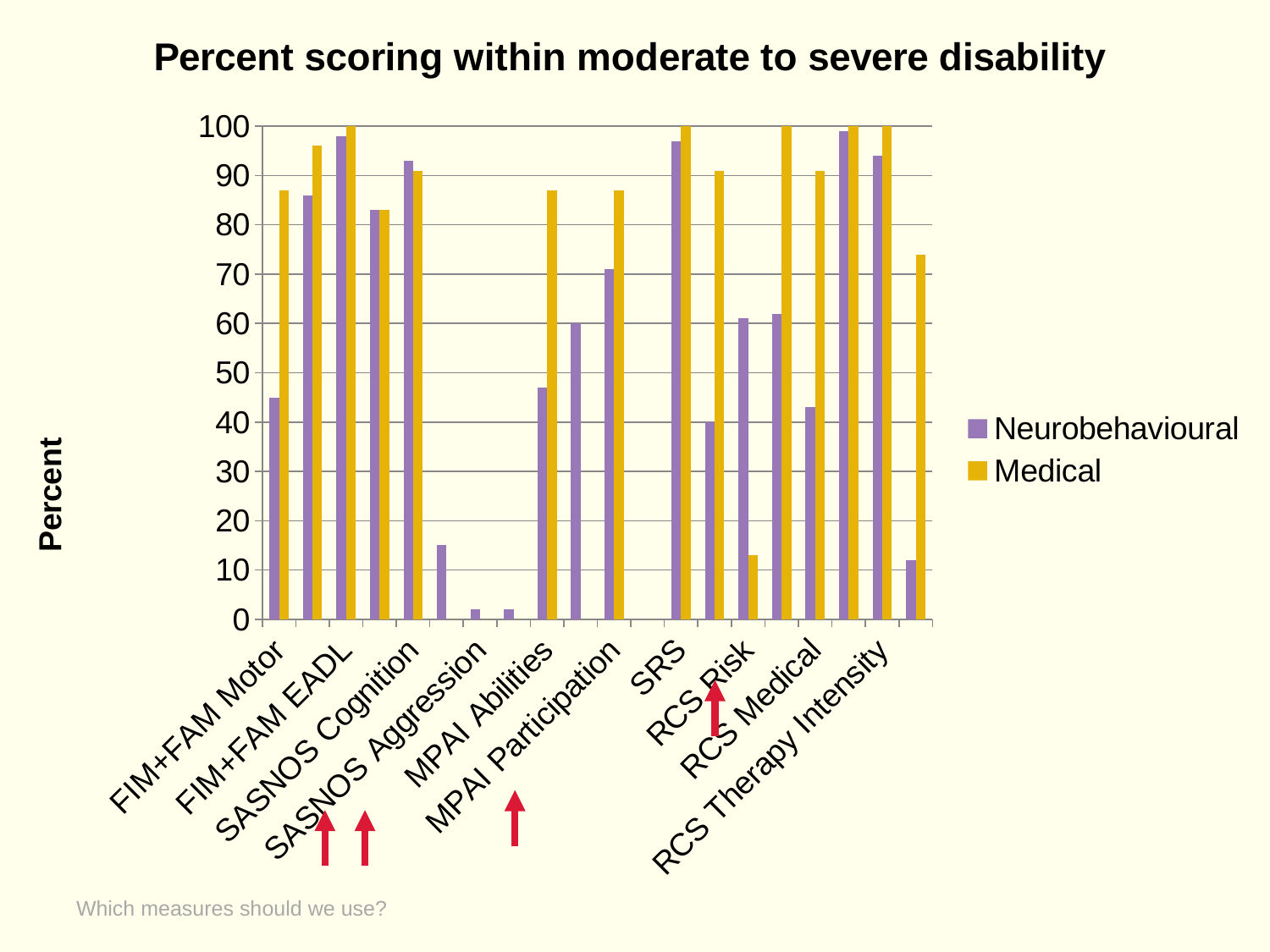
In the rightmost group of bars, which series has the larger value, Neurobehavioural or Medical? Medical In the leftmost group of bars, which series has the larger value, Neurobehavioural or Medical? Medical How many series does the legend list? 2 Is the Medical value in the leftmost group of bars greater or less than 80? greater Is the Neurobehavioural value in the leftmost group of bars greater or less than 50? less Is the Medical value in the rightmost group of bars greater or less than 70? greater What is the title of the vertical axis? Percent How many category labels are shown along the x axis? 10 What are the two series named in the legend? Neurobehavioural and Medical What kind of chart is shown on the slide? bar chart